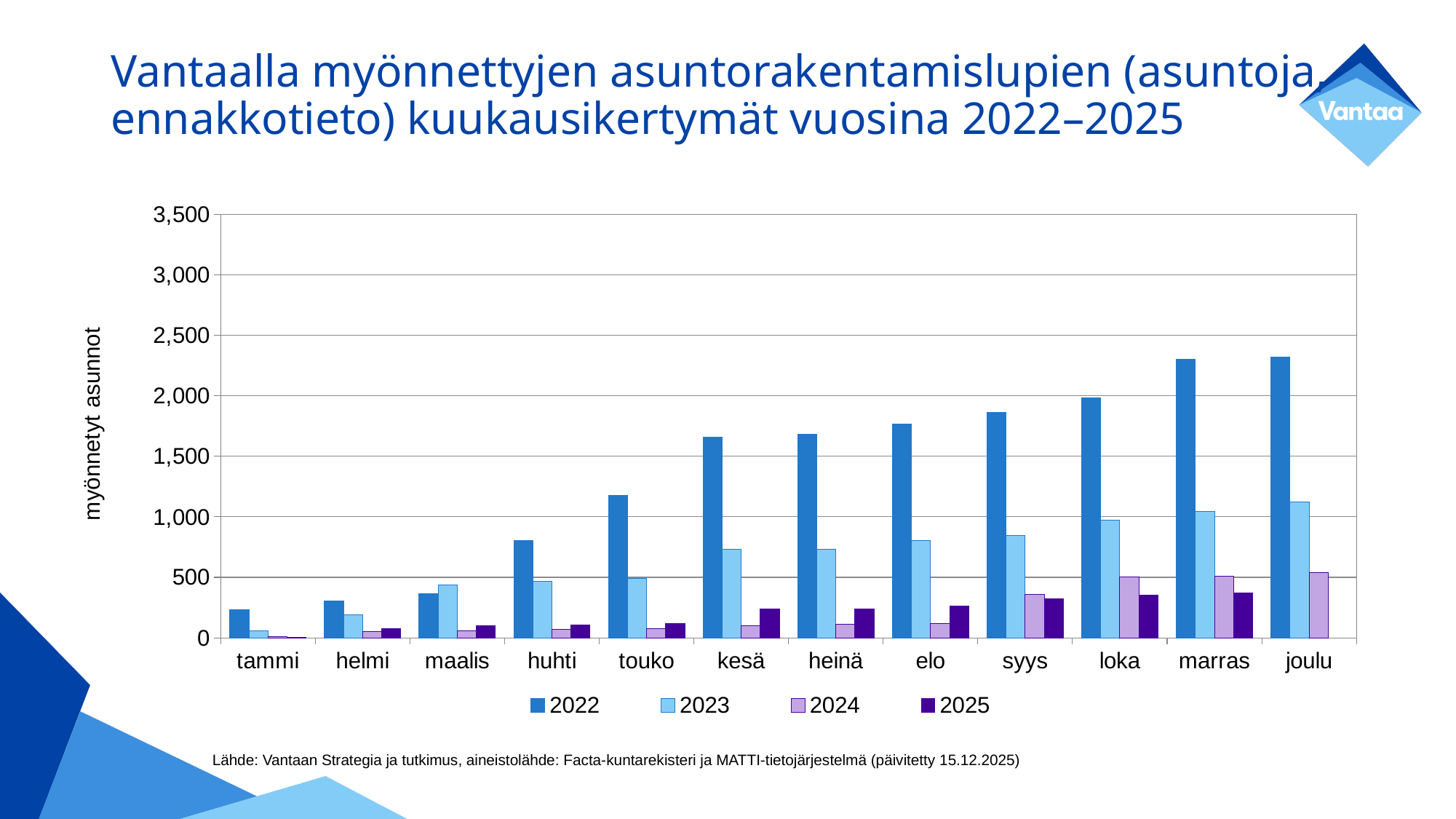
What kind of chart is shown on the slide? bar chart Which month has the lowest value for the 2023 series? tammi For maalis, which series has the larger value, 2022 or 2023? 2023 Which month has the highest value for the 2023 series? joulu Do the 2022 values rise or fall from tammi to joulu? rise For loka, which series has the larger value, 2024 or 2025? 2024 Is the 2022 value for touko greater or less than 1,000? greater How many months are shown on the x axis? 12 Is the 2023 value for joulu greater or less than 1,000? greater Is the 2022 value for joulu greater or less than 2,000? greater How many series does the legend list? 4